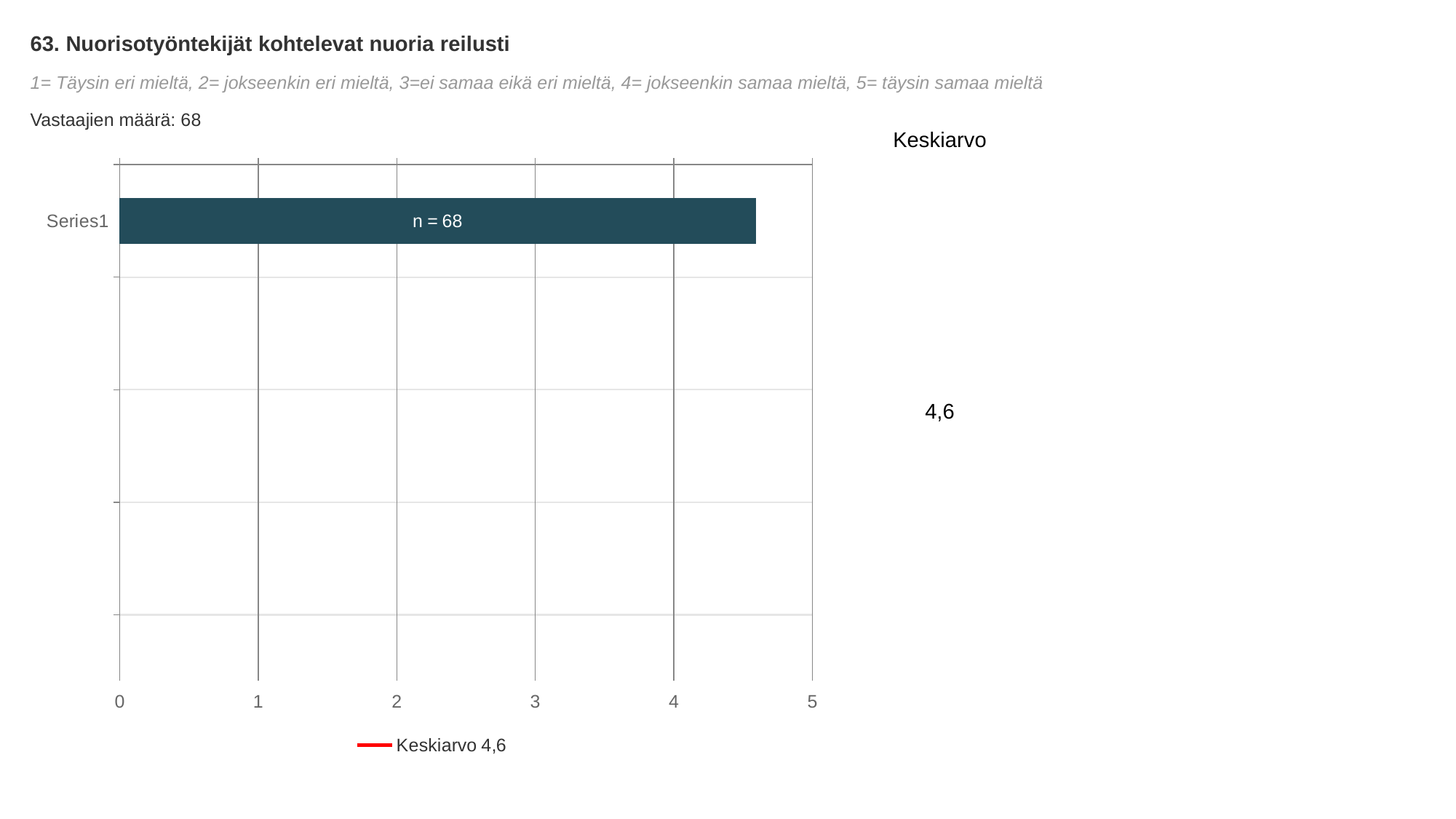
What kind of chart is shown on the slide? bar chart What is the number of respondents (Vastaajien määrä) stated on the slide? 68 What is the title of the chart on the slide? 63. Nuorisotyöntekijät kohtelevat nuoria reilusti How many bars does the chart contain? 1 What is the Keskiarvo (mean) value shown on the slide? 4,6 How many entries does the chart legend list? 1 Is the value for Series1 greater or less than 4? greater What is the highest value shown on the horizontal axis? 5 What data label is printed on the Series1 bar? n = 68 Is the value for Series1 greater or less than 5? less